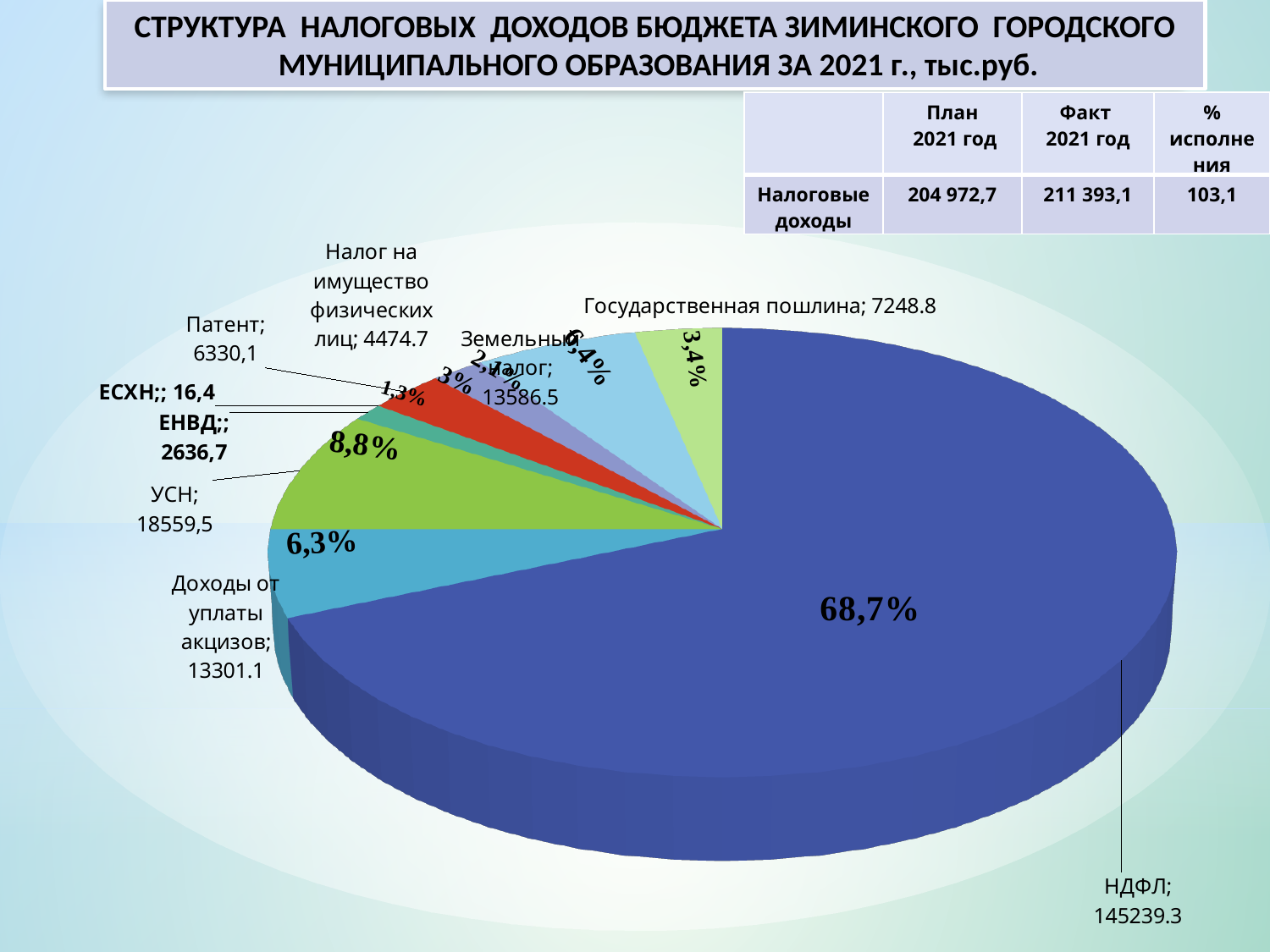
Which category has the largest slice of the pie? НДФЛ What is the value shown for Земельный налог? 13586.5 How many categories are shown in the pie chart? 9 Which category has the smallest value? ЕСХН Which is larger, the value for УСН or the value for Доходы от уплаты акцизов? УСН What kind of chart is shown on the slide? Pie chart What share of the pie does УСН account for? 8,8% What is the value shown for Государственная пошлина? 7248.8 What is the value shown for НДФЛ? 145239.3 What share of the pie does НДФЛ account for? 68,7% What is the value shown for Патент? 6330,1 What is the value shown for УСН? 18559,5